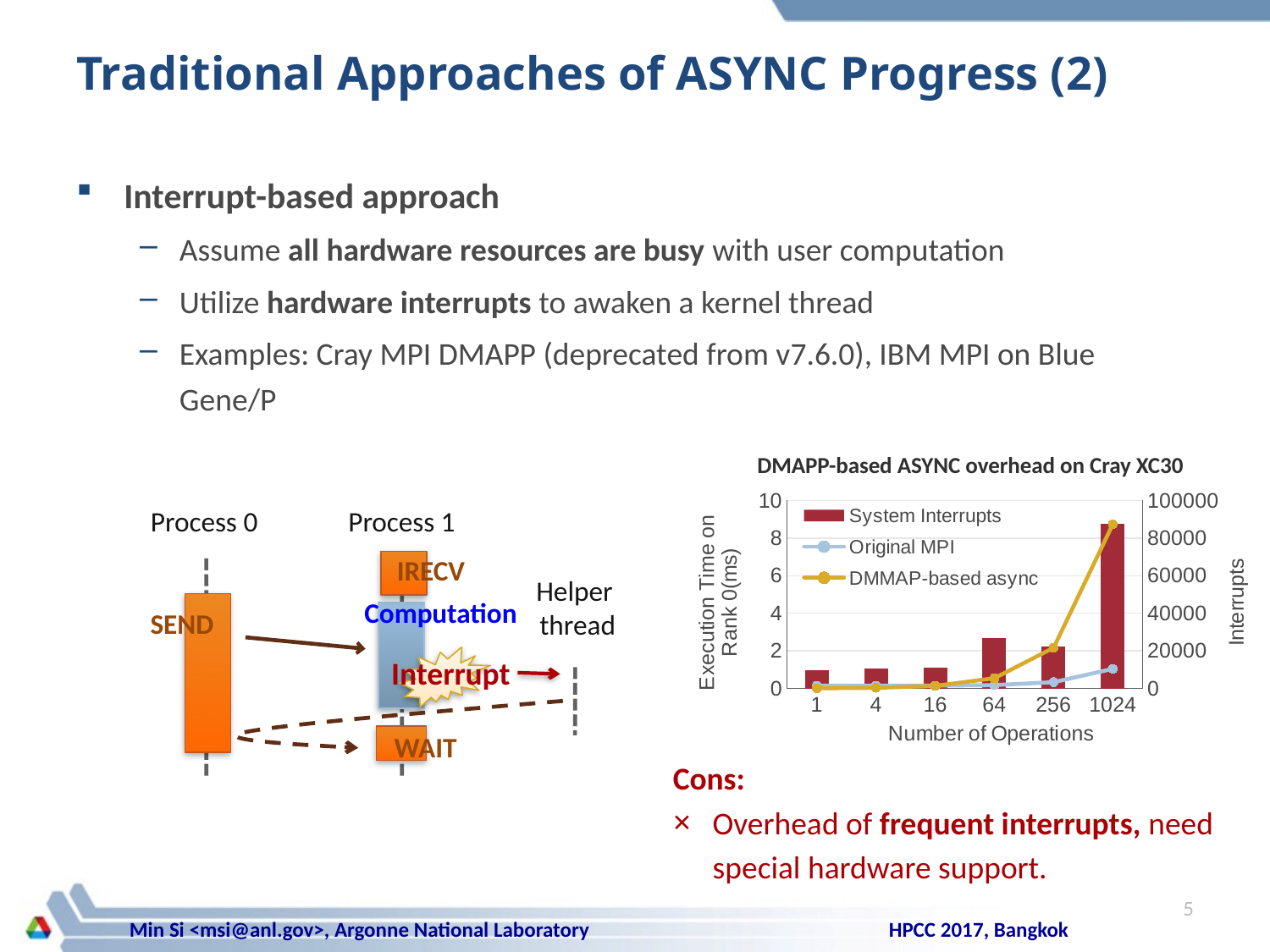
What is the label of the right-hand vertical axis of the chart? Interrupts What is the title of the chart on the slide? DMAPP-based ASYNC overhead on Cray XC30 Is the System Interrupts value at 1 operation greater or less than 20000? less Does the DMMAP-based async execution time rise or fall as the number of operations increases? rise How many series does the chart's legend list? 3 How many categories are shown on the x axis (Number of Operations) of the chart? 6 At which number of operations is the System Interrupts value highest? 1024 Is the Original MPI execution time at 1024 operations greater or less than 2 ms? less At 1024 operations, which has the larger execution time: Original MPI or DMMAP-based async? DMMAP-based async Is the DMMAP-based async execution time at 1024 operations greater or less than 6 ms? greater What kind of chart is used for the System Interrupts series? bar chart